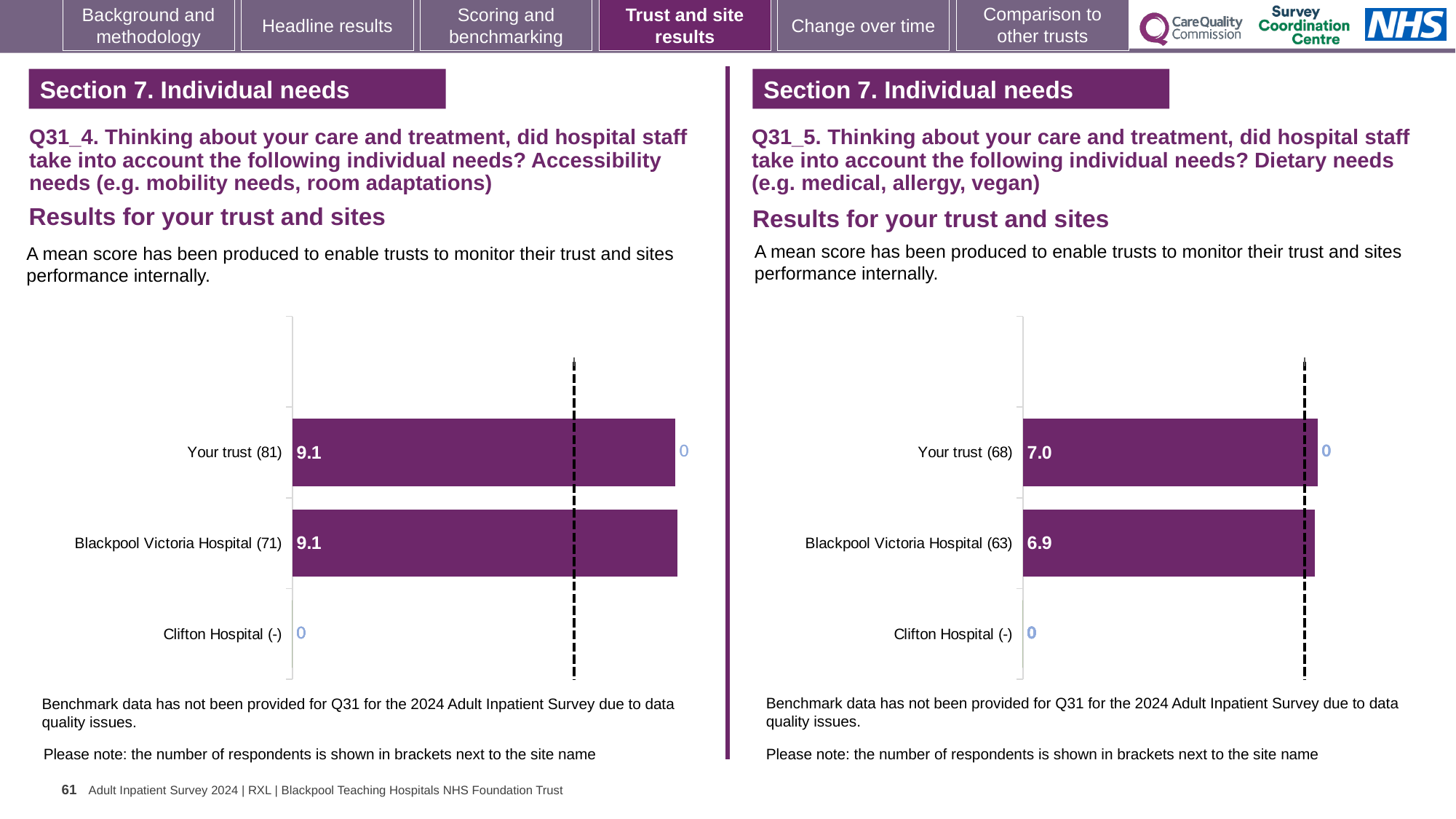
In the left chart (Q31_4, Accessibility needs), what is the difference between the mean score for Your trust and the mean score for Blackpool Victoria Hospital? 0.0 What kind of chart is used in the right chart (Q31_5, Dietary needs)? Bar chart In the left chart (Q31_4, Accessibility needs), how many respondents are shown in brackets for Your trust? 81 In the left chart (Q31_4, Accessibility needs), what is the mean score for Your trust? 9.1 In the right chart (Q31_5, Dietary needs), what is the difference between the mean score for Your trust and the mean score for Blackpool Victoria Hospital? 0.1 In the left chart (Q31_4, Accessibility needs), what is the mean score for Blackpool Victoria Hospital? 9.1 In the right chart (Q31_5, Dietary needs), what is the mean score for Your trust? 7.0 In the left chart (Q31_4, Accessibility needs), how many categories are shown on the vertical axis? 3 In the right chart (Q31_5, Dietary needs), which has the higher mean score, Your trust or Blackpool Victoria Hospital? Your trust In the right chart (Q31_5, Dietary needs), what is the mean score for Blackpool Victoria Hospital? 6.9 In the right chart (Q31_5, Dietary needs), how many respondents are shown in brackets for Blackpool Victoria Hospital? 63